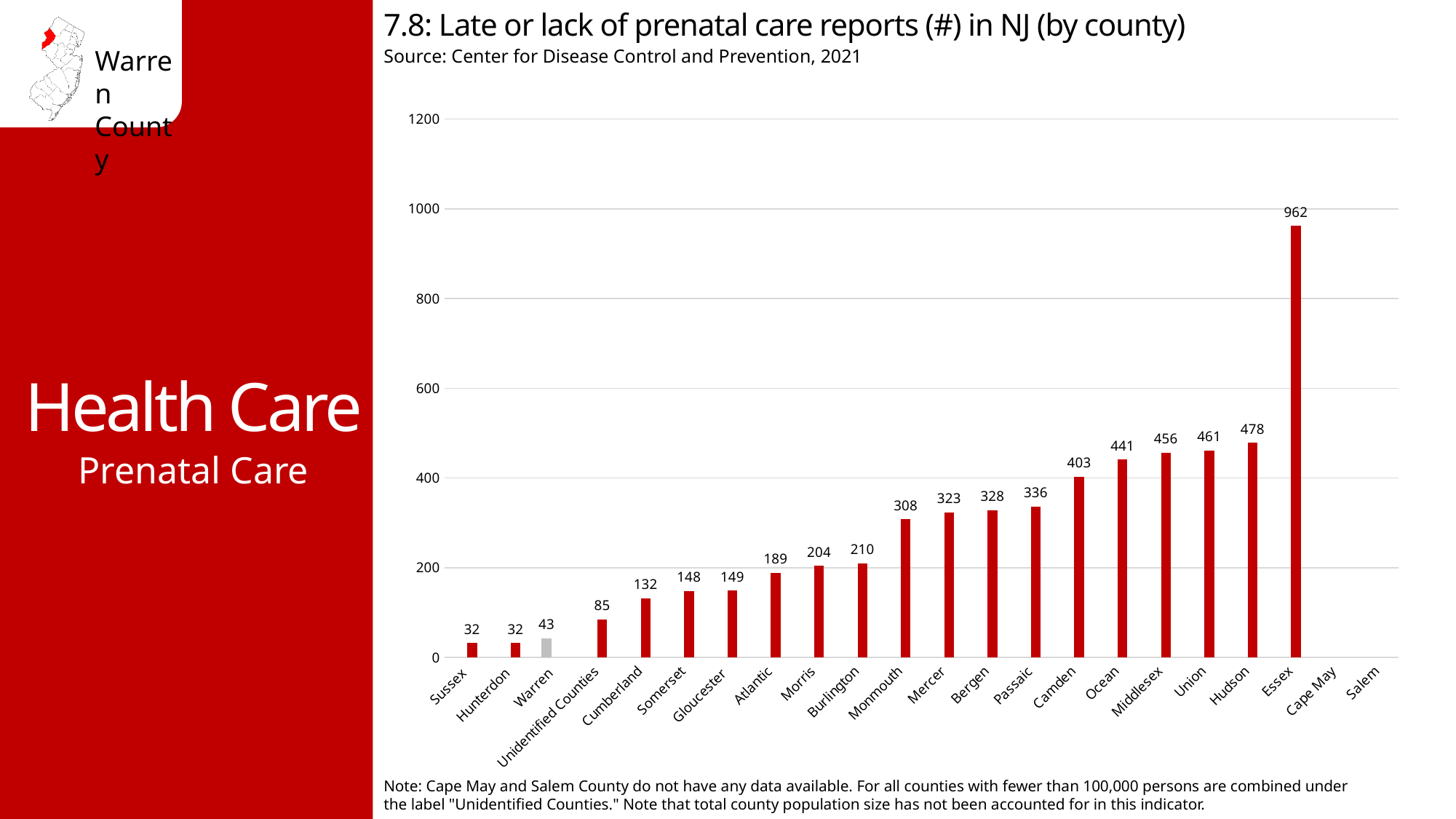
Which county has the highest number of late or lack of prenatal care reports? Essex Which bar is coloured grey instead of red? Warren What is the difference between the values for Essex and Hudson? 484 Do the bar values generally rise or fall from Sussex to Essex along the x axis? Rise What is the difference between the values for Hudson and Union? 17 What is the value shown for Cumberland County? 132 Which has a larger value, Camden or Monmouth? Camden How many county labels are shown on the x axis of the chart? 22 Is the value for Ocean greater or less than 400? greater What is the value shown for Essex County? 962 What kind of chart is shown on the slide? Bar chart What is the number of late or lack of prenatal care reports for Warren County? 43